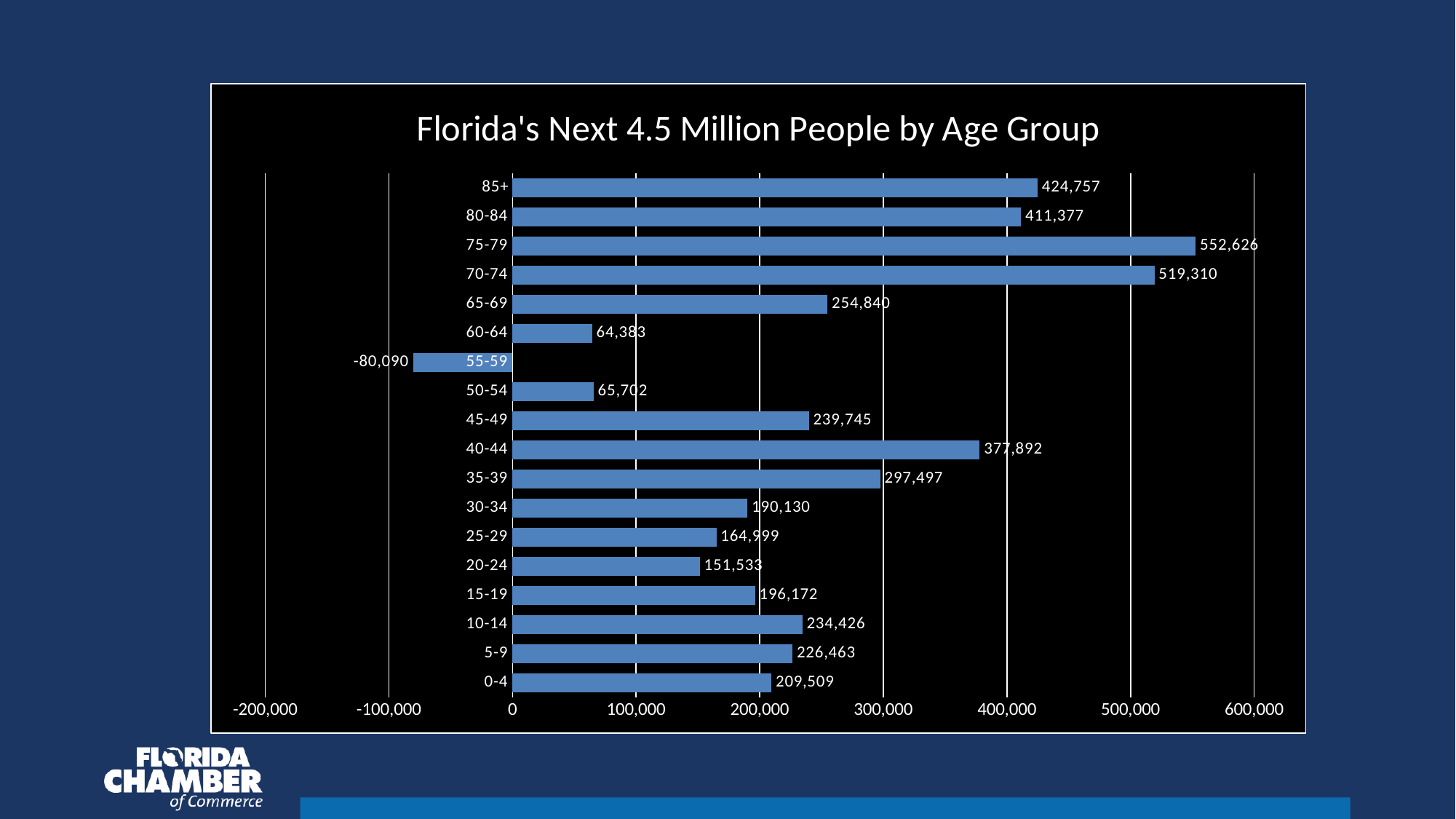
What is the value for the 55-59 age group? -80,090 What kind of chart is shown on the slide? Bar chart Is the value for the 65-69 age group greater or less than 200,000? greater How many age groups are shown in the chart? 18 What is the difference between the values for the 75-79 and 70-74 age groups? 33,316 What is the value for the 0-4 age group? 209,509 Which age group has the highest value? 75-79 Which has a larger value, the 40-44 age group or the 35-39 age group? 40-44 What is the value for the 75-79 age group? 552,626 What is the title of the chart? Florida's Next 4.5 Million People by Age Group What is the difference between the values for the 85+ and 80-84 age groups? 13,380 Which age group has the lowest value? 55-59